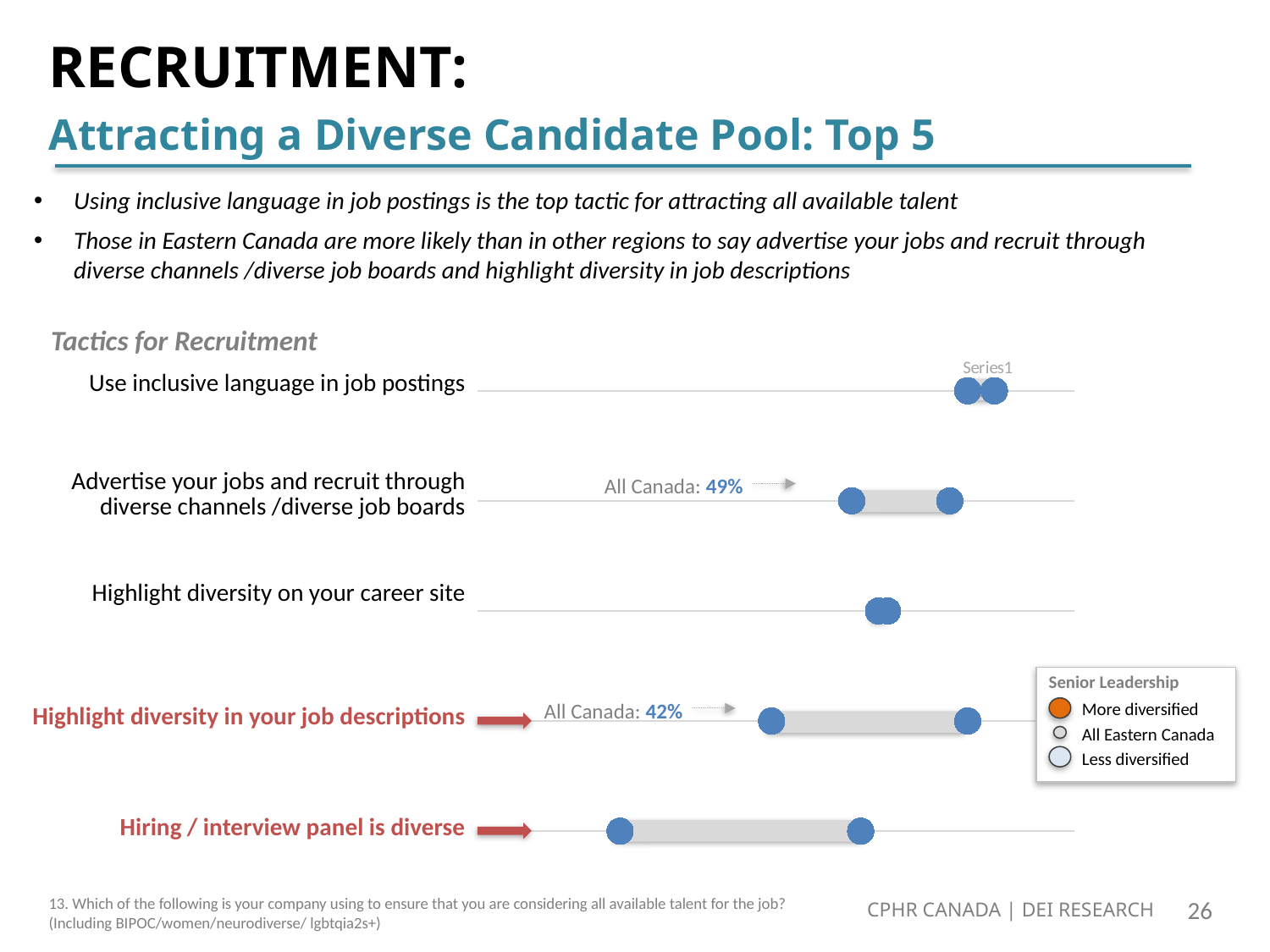
What is the title of the chart on the slide? Tactics for Recruitment How many entries does the 'Senior Leadership' legend list? 3 What is the All Canada value for 'Advertise your jobs and recruit through diverse channels /diverse job boards'? 49% How many recruitment tactics are listed as categories in the chart? 5 Which tactic shows the widest gap between its two markers? Hiring / interview panel is diverse Which tactic's markers are positioned furthest to the right in the chart? Use inclusive language in job postings What is the difference between the All Canada values for 'Advertise your jobs and recruit through diverse channels /diverse job boards' and 'Highlight diversity in your job descriptions'? 7 percentage points What is the All Canada value for 'Highlight diversity in your job descriptions'? 42% Which tactic is listed last (at the bottom) in the chart? Hiring / interview panel is diverse Which has the higher All Canada value: 'Advertise your jobs and recruit through diverse channels /diverse job boards' or 'Highlight diversity in your job descriptions'? Advertise your jobs and recruit through diverse channels /diverse job boards What kind of chart is used to show the tactics for recruitment? Dot plot (range chart)